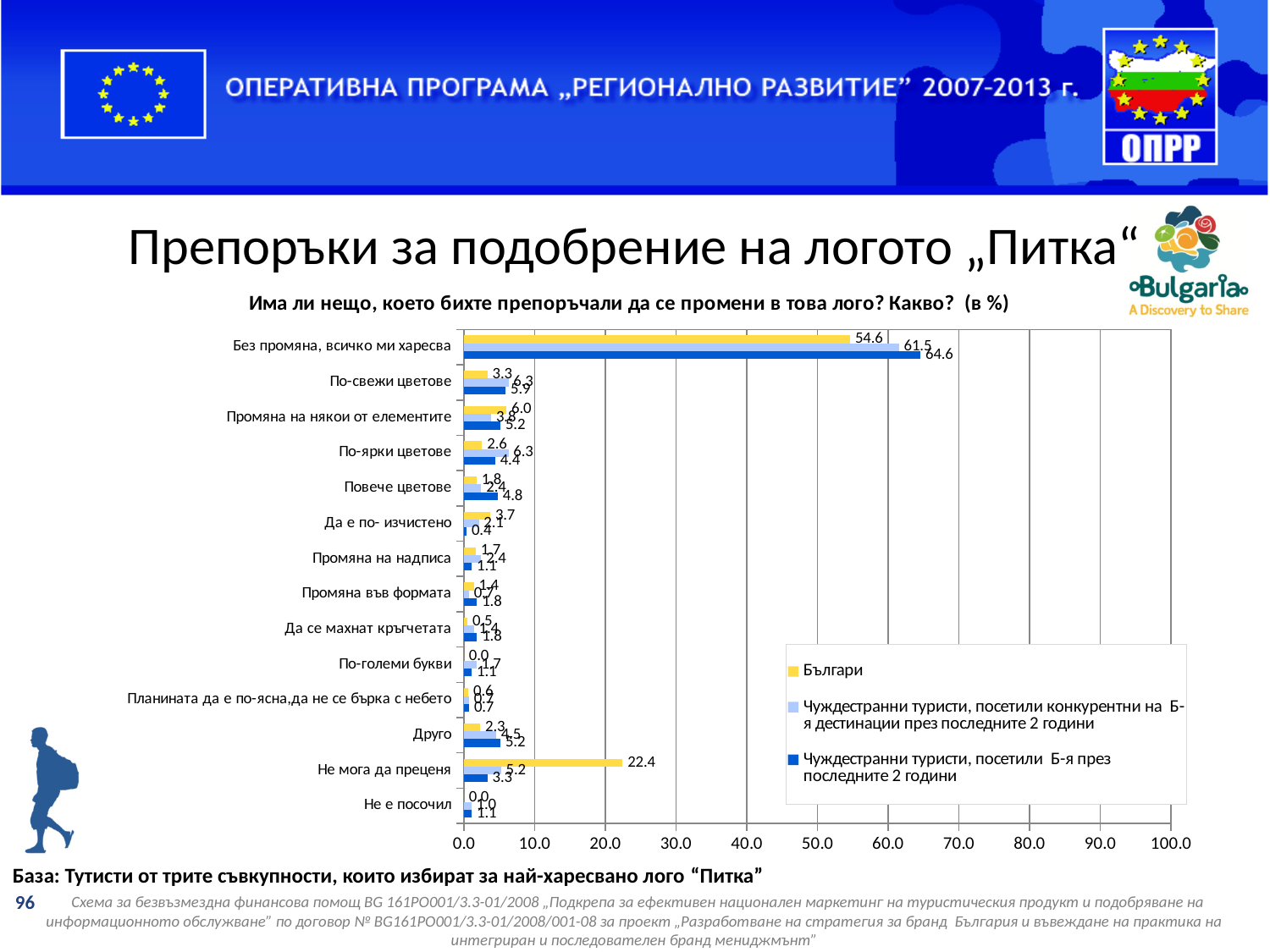
Which category has the highest value for the Българи series? Без промяна, всичко ми харесва What is the value for "Чуждестранни туристи, посетили Б-я през последните 2 години" in the category "Без промяна, всичко ми харесва"? 64.6 What is the difference between the values for "Чуждестранни туристи, посетили Б-я през последните 2 години" and Българи in the category "Без промяна, всичко ми харесва"? 10.0 In the category "Не мога да преценя", which series has the larger value: Българи or "Чуждестранни туристи, посетили Б-я през последните 2 години"? Българи How many series does the legend list? 3 What type of chart is shown on the slide? bar chart What is the value for Българи in the category "Не мога да преценя"? 22.4 How many categories are shown on the vertical axis of the chart? 14 What is the value for "Чуждестранни туристи, посетили конкурентни на Б-я дестинации през последните 2 години" in the category "Без промяна, всичко ми харесва"? 61.5 Which colour represents the Българи series in the chart? yellow Is the value for Българи in the category "Без промяна, всичко ми харесва" greater or less than 50.0? greater What is the value for Българи in the category "Без промяна, всичко ми харесва"? 54.6